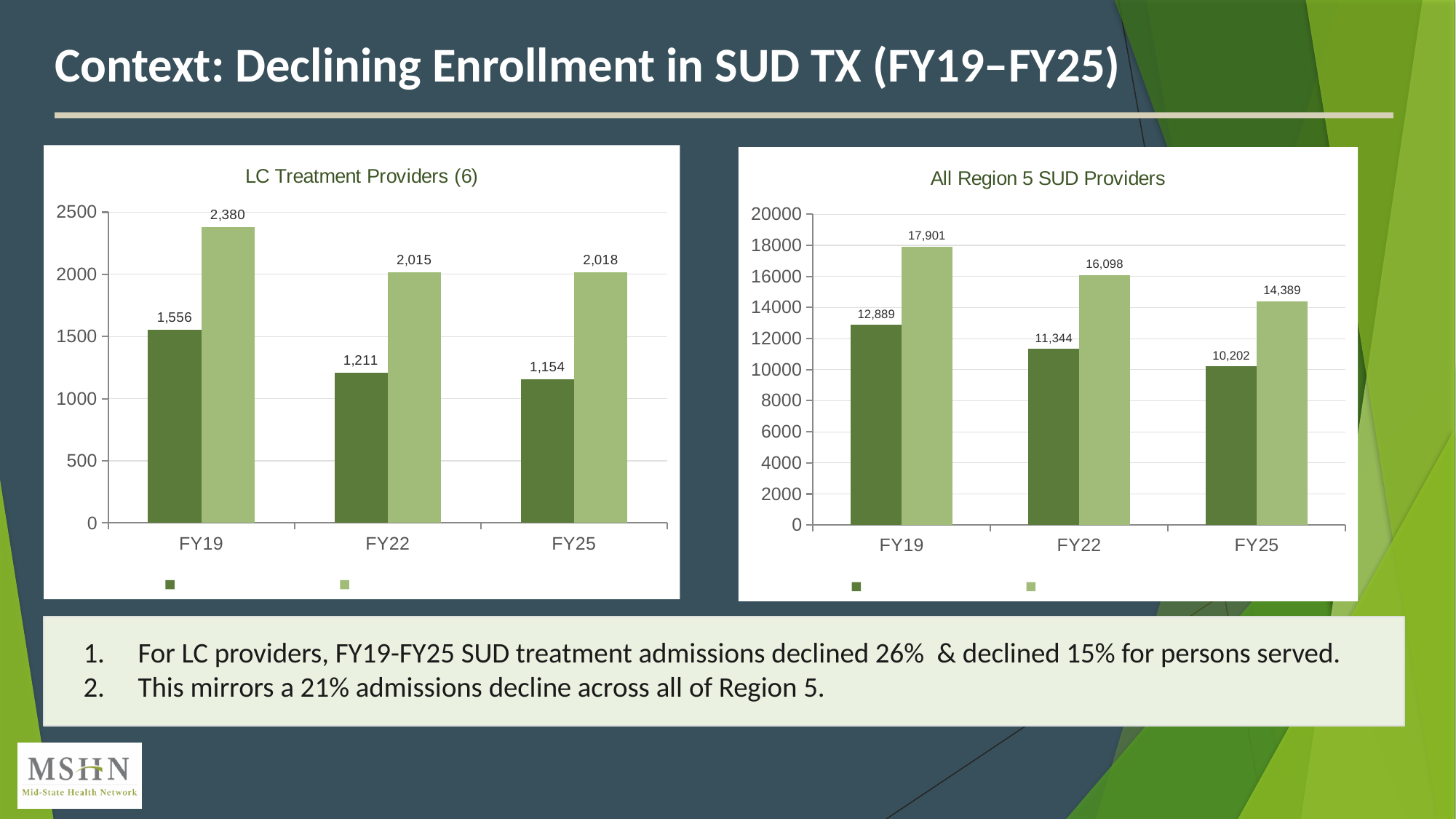
In the 'All Region 5 SUD Providers' chart, which is larger: the dark green bar for FY19 or the dark green bar for FY22? FY19 In the 'LC Treatment Providers (6)' chart, what is the value of the dark green bar for FY19? 1,556 In the 'All Region 5 SUD Providers' chart, what is the value of the light green bar for FY22? 16,098 In the 'LC Treatment Providers (6)' chart, what is the value of the light green bar for FY25? 2,018 In the 'LC Treatment Providers (6)' chart, what is the difference between the dark green bars for FY19 and FY25? 402 In the 'All Region 5 SUD Providers' chart, do the dark green bars rise or fall from FY19 to FY25? fall In the 'LC Treatment Providers (6)' chart, which fiscal year has the lowest dark green bar? FY25 In the 'All Region 5 SUD Providers' chart, what is the difference between the light green bars for FY19 and FY25? 3,512 What type of chart is the 'All Region 5 SUD Providers' chart? bar chart How many fiscal years are shown on the x axis of the 'LC Treatment Providers (6)' chart? 3 In the 'All Region 5 SUD Providers' chart, what is the value of the dark green bar for FY25? 10,202 In the 'All Region 5 SUD Providers' chart, which fiscal year has the highest light green bar? FY19